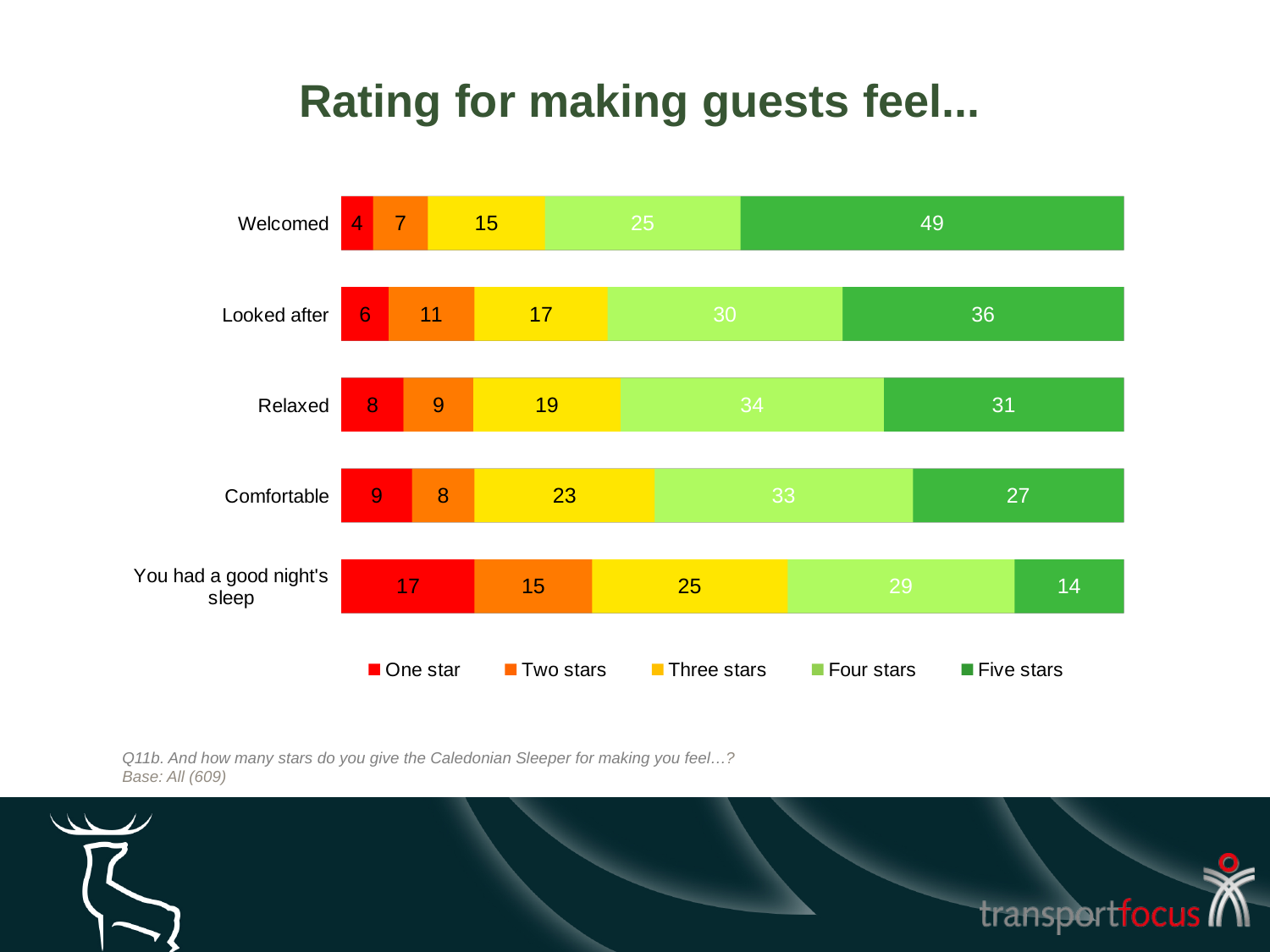
What is the Four stars value for Relaxed? 34 Which is larger, the Four stars value for Looked after or the Four stars value for Comfortable? Comfortable Which category has the highest Five stars value? Welcomed What kind of chart is shown on the slide? Stacked bar chart What is the difference between the Five stars values for Welcomed and Looked after? 13 How many categories are shown on the chart? 5 How many series does the legend list? 5 Which category has the lowest Five stars value? You had a good night's sleep What is the Three stars value for Comfortable? 23 What is the total of the stacked bar for Relaxed? 101 What is the One star value for 'You had a good night's sleep'? 17 What is the Five stars value for Welcomed? 49